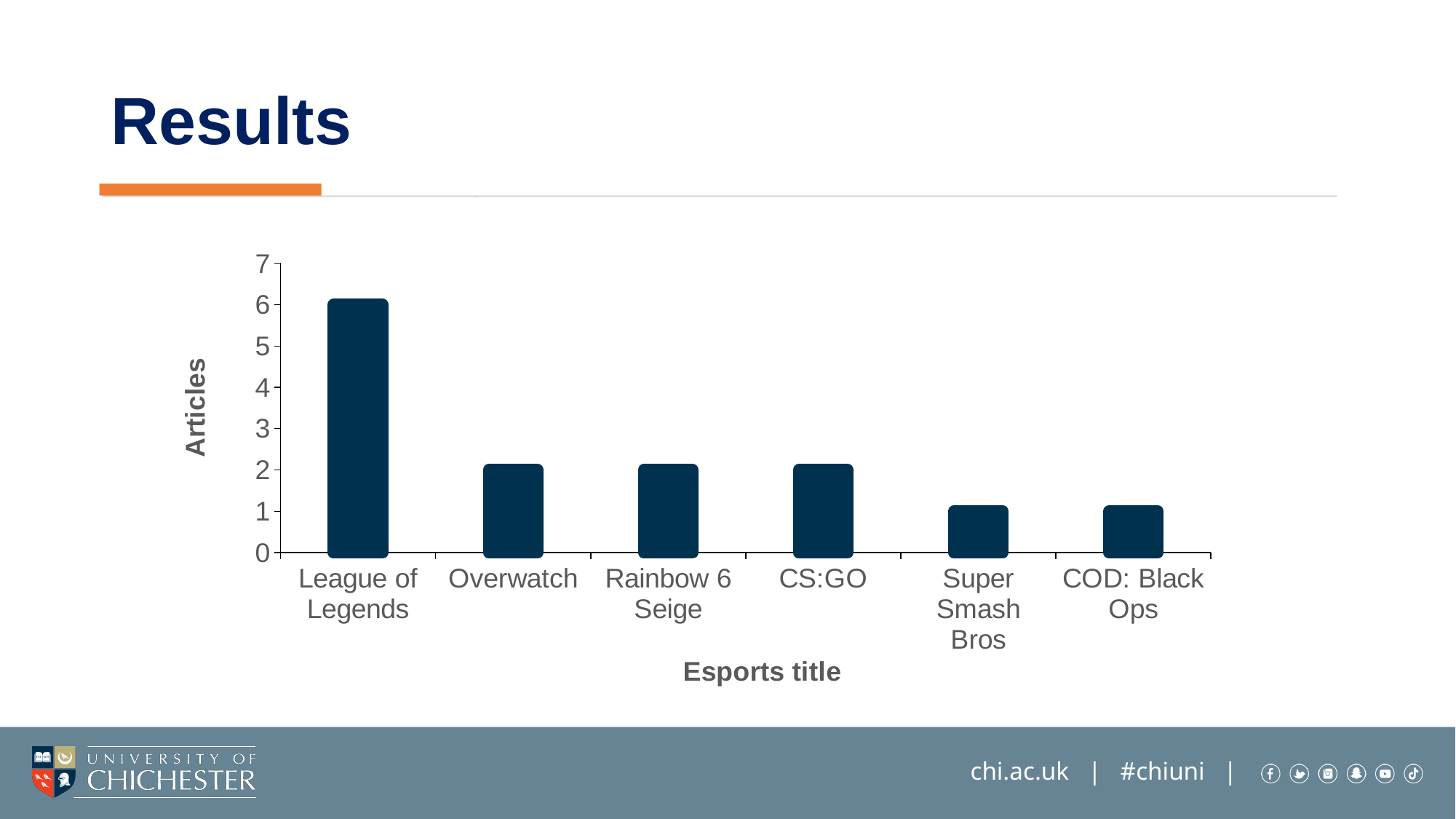
Is the value for Super Smash Bros greater or less than 2? less Which has more articles, League of Legends or Overwatch? League of Legends What is the label on the vertical axis of the chart? Articles Is the value for Overwatch greater or less than 3? less Which has more articles, Rainbow 6 Seige or COD: Black Ops? Rainbow 6 Seige Is the value for League of Legends greater or less than 5? greater Do the bar values generally rise or fall from left to right along the x axis? fall Which esports title has the highest number of articles? League of Legends What is the label on the horizontal axis of the chart? Esports title What kind of chart is shown on the slide? bar chart How many esports titles are shown on the x axis of the chart? 6